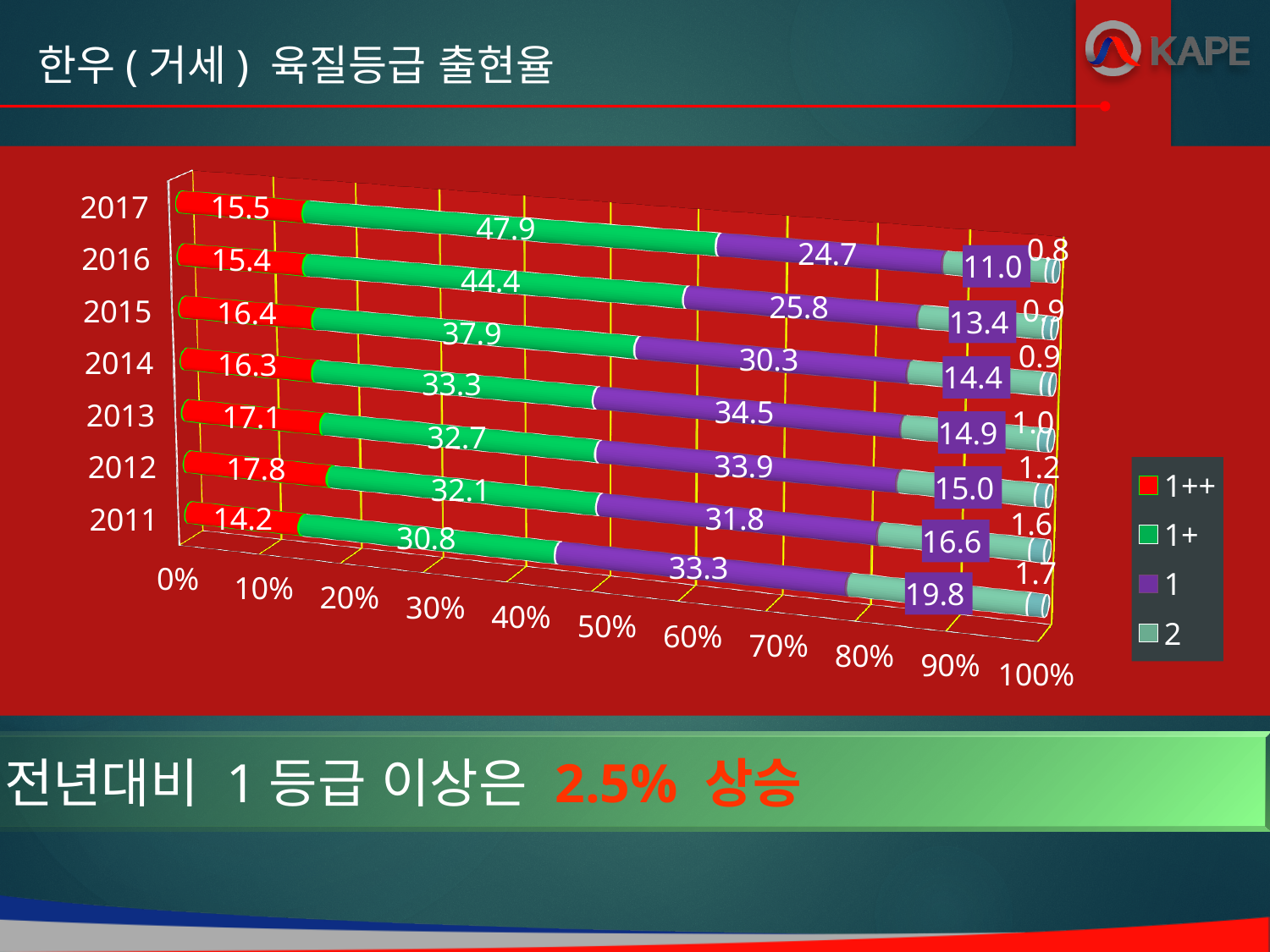
What is the value of the 1++ series for 2017? 15.5 Which year has the highest value for the 1+ series? 2017 How many years are shown on the chart? 7 What is the value of the 1+ series for 2011? 30.8 Which is larger, the value of the 1 series for 2014 or for 2013? 2014 Does the value of the 2 series rise or fall from 2011 to 2017? fall What is the value of the 2 series for 2012? 16.6 What is the title of the slide? 한우 ( 거세 ) 육질등급 출현율 What kind of chart is shown on the slide? stacked bar chart What is the difference between the 1+ values for 2017 and 2016? 3.5 Which year has the lowest value for the 1++ series? 2011 How many series does the legend list? 4